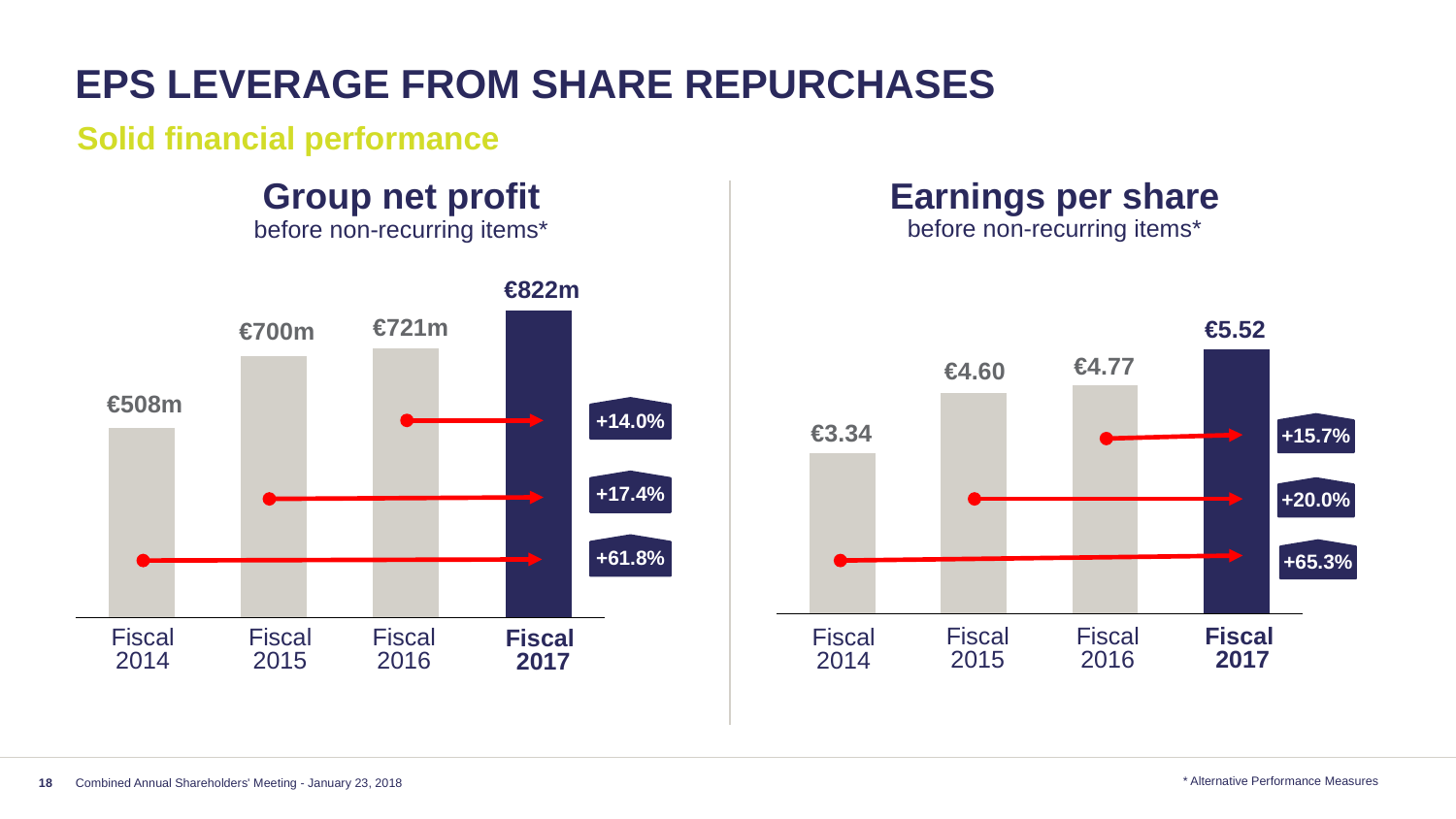
In the Group net profit chart, what is the value for Fiscal 2014? €508m In the Earnings per share chart, what is the value for Fiscal 2016? €4.77 In the Earnings per share chart, do the values rise or fall from Fiscal 2014 to Fiscal 2017? Rise In the Group net profit chart, what is the difference between the Fiscal 2017 and Fiscal 2016 values? €101m In the Group net profit chart, which is larger, the value for Fiscal 2015 or Fiscal 2016? Fiscal 2016 How many fiscal years are shown in the Earnings per share chart? 4 In the Earnings per share chart, what is the difference between the Fiscal 2017 and Fiscal 2014 values? €2.18 In the Earnings per share chart, which fiscal year has the lowest value? Fiscal 2014 What kind of chart is the Group net profit chart? Bar chart In the Earnings per share chart, what is the value for Fiscal 2015? €4.60 In the Group net profit chart, which fiscal year has the highest value? Fiscal 2017 In the Group net profit chart, what is the value for Fiscal 2017? €822m